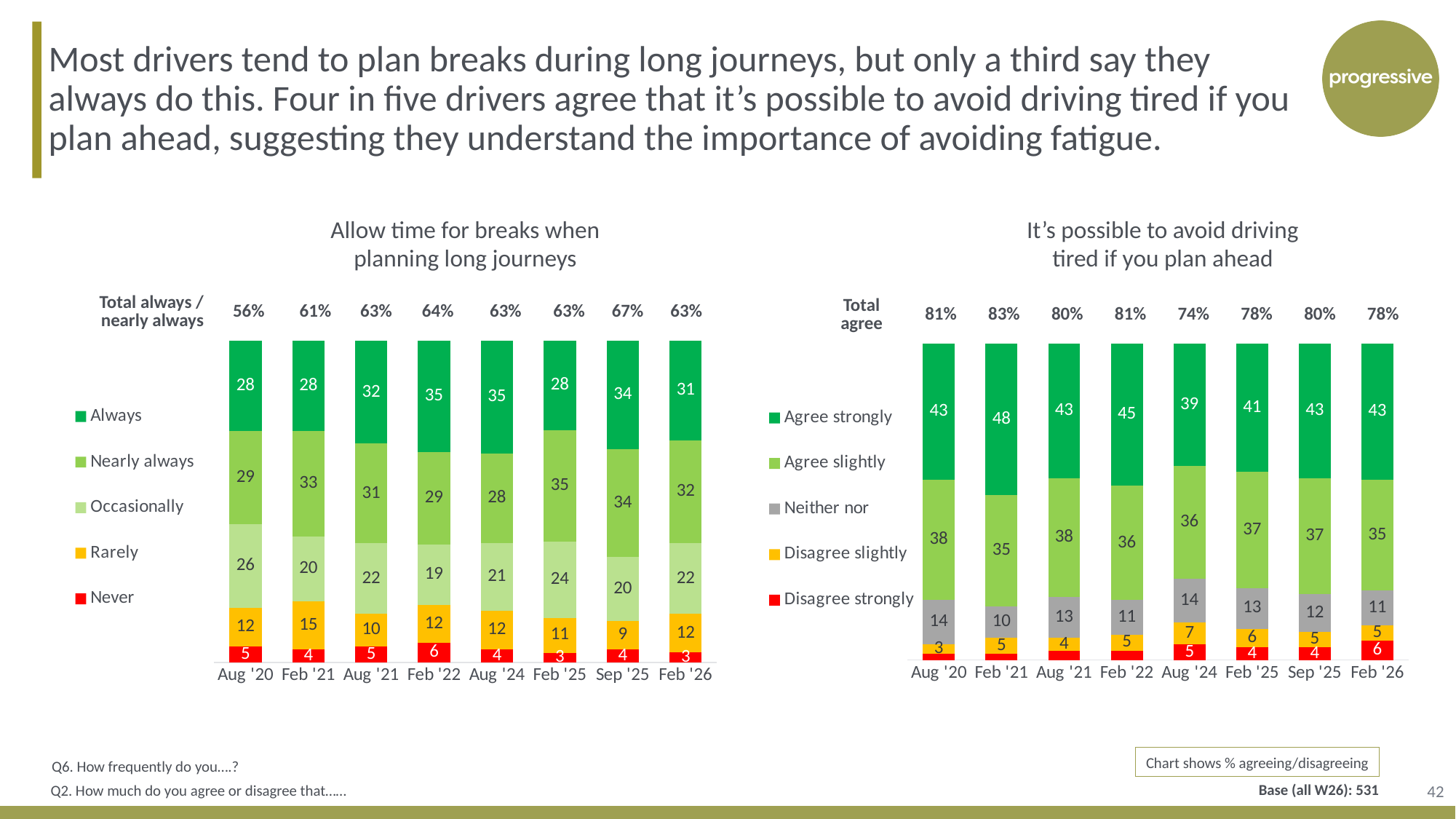
In the 'Allow time for breaks when planning long journeys' chart, which wave has the lowest Total always / nearly always figure? Aug '20 In the 'It's possible to avoid driving tired if you plan ahead' chart, what is the value for Disagree strongly in Feb '26? 6 In the 'Allow time for breaks when planning long journeys' chart, what is the value for Always in Feb '22? 35 In the 'It's possible to avoid driving tired if you plan ahead' chart, which is larger: Neither nor in Aug '20 or Neither nor in Feb '21? Aug '20 How many waves (x-axis categories) are shown in the 'It's possible to avoid driving tired if you plan ahead' chart? 8 In the 'Allow time for breaks when planning long journeys' chart, what is the Total always / nearly always figure for Sep '25? 67% In the 'Allow time for breaks when planning long journeys' chart, what is the difference between the Rarely values for Feb '21 and Sep '25? 6 What type of chart is the 'Allow time for breaks when planning long journeys' chart? Stacked bar chart In the 'Allow time for breaks when planning long journeys' chart, how many series does the legend list? 5 In the 'It's possible to avoid driving tired if you plan ahead' chart, which wave has the lowest Total agree figure? Aug '24 In the 'It's possible to avoid driving tired if you plan ahead' chart, what is the value for Agree strongly in Feb '21? 48 In the 'Allow time for breaks when planning long journeys' chart, which wave has the highest Total always / nearly always figure? Sep '25